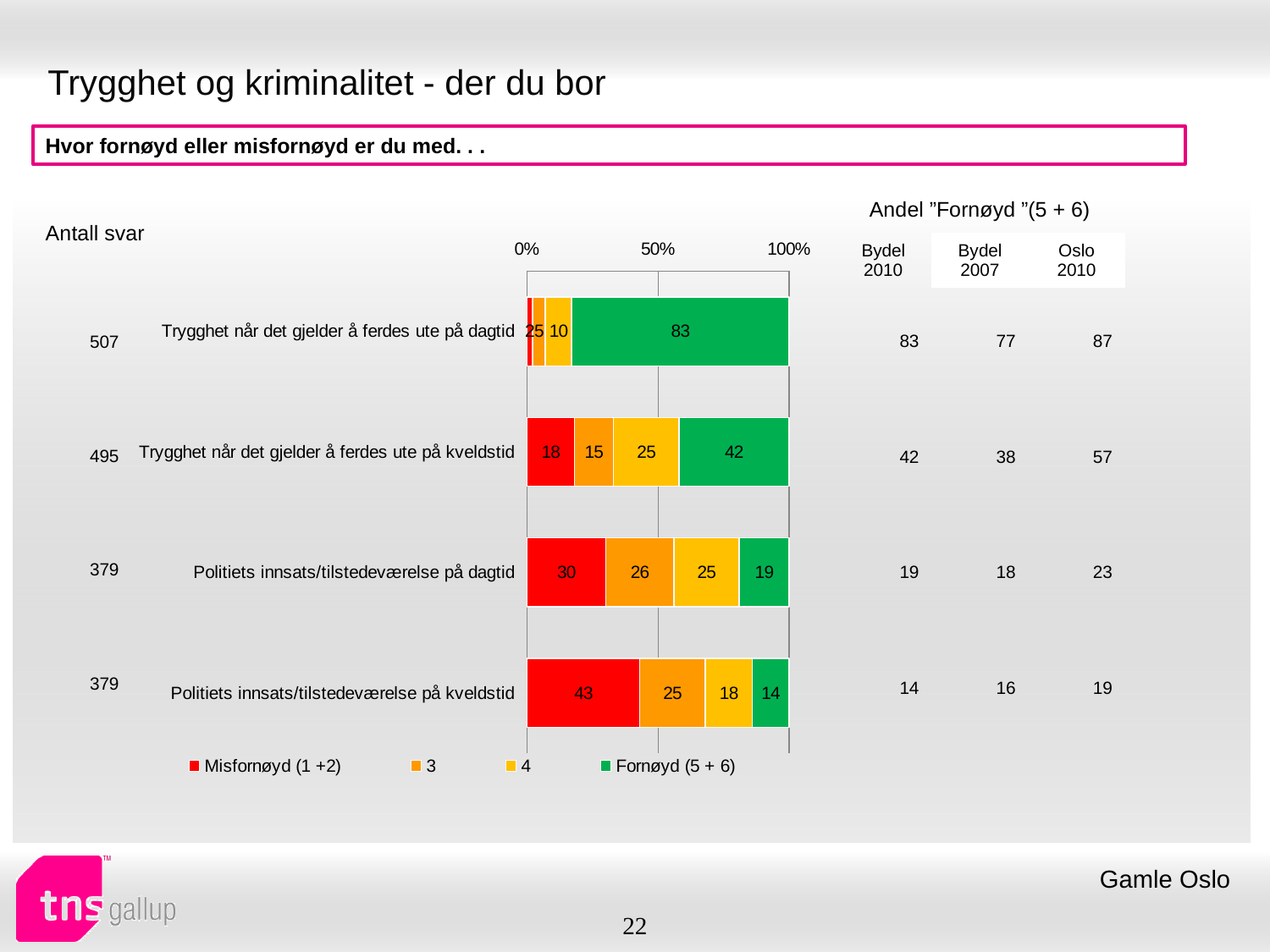
Which is larger: the Fornøyd (5 + 6) value for 'Trygghet når det gjelder å ferdes ute på kveldstid' or for 'Politiets innsats/tilstedeværelse på dagtid'? Trygghet når det gjelder å ferdes ute på kveldstid Which category has the highest Fornøyd (5 + 6) value? Trygghet når det gjelder å ferdes ute på dagtid What colour represents the Fornøyd (5 + 6) series in the chart? green How many series does the chart legend list? 4 What is the difference between the Misfornøyd (1 +2) values for 'Politiets innsats/tilstedeværelse på kveldstid' and 'Politiets innsats/tilstedeværelse på dagtid'? 13 What is the value of the '3' segment for 'Trygghet når det gjelder å ferdes ute på kveldstid'? 15 How many categories are plotted in the chart? 4 Which category has the lowest Fornøyd (5 + 6) value? Politiets innsats/tilstedeværelse på kveldstid What is the value of the '4' segment for 'Politiets innsats/tilstedeværelse på dagtid'? 25 What is the value of the Misfornøyd (1 +2) segment for 'Politiets innsats/tilstedeværelse på kveldstid'? 43 What kind of chart is shown on the slide? stacked bar chart What is the value of the Fornøyd (5 + 6) segment for 'Trygghet når det gjelder å ferdes ute på dagtid'? 83